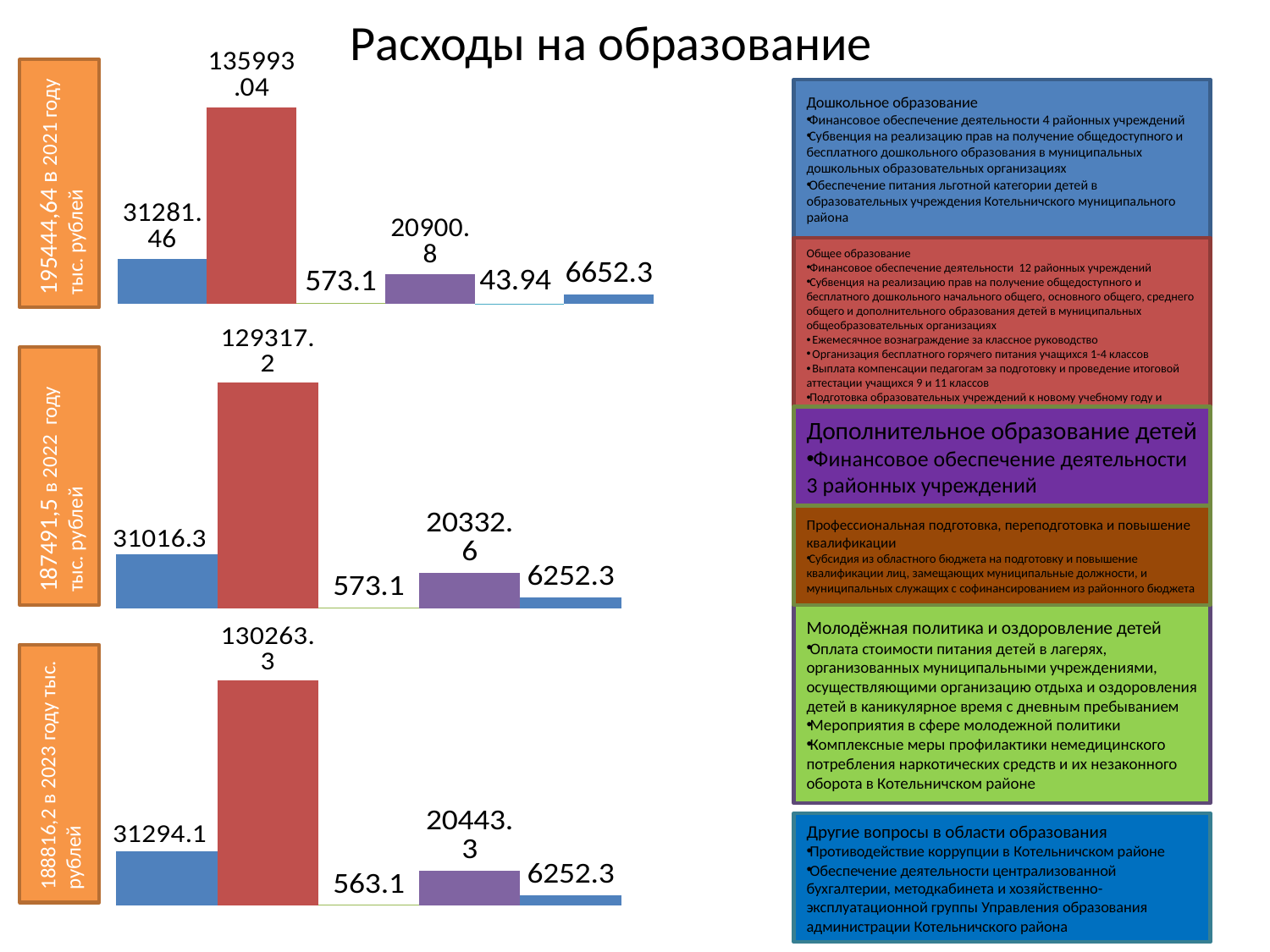
In the 2022 chart (middle), how many bars are plotted? 5 In the 2021 chart (top), what is the smallest labelled value? 43.94 How many bar charts are on the slide? 3 In the 2022 chart (middle), what is the value of the purple bar? 20332.6 In the 2023 chart (bottom), what is the smallest labelled value? 563.1 In the 2023 chart (bottom), what is the value of the first (blue) bar? 31294.1 In the 2021 chart (top), what is the value of the tallest (red) bar? 135993.04 In the 2022 chart (middle), what is the value of the tallest (red) bar? 129317.2 In the 2023 chart (bottom), which is larger: the purple bar (20443.3) or the last light-blue bar (6252.3)? the purple bar (20443.3) What is the title of the slide containing the charts? Расходы на образование In the 2021 chart (top), how many bars are plotted? 6 In the 2021 chart (top), what is the value of the first (blue) bar? 31281.46